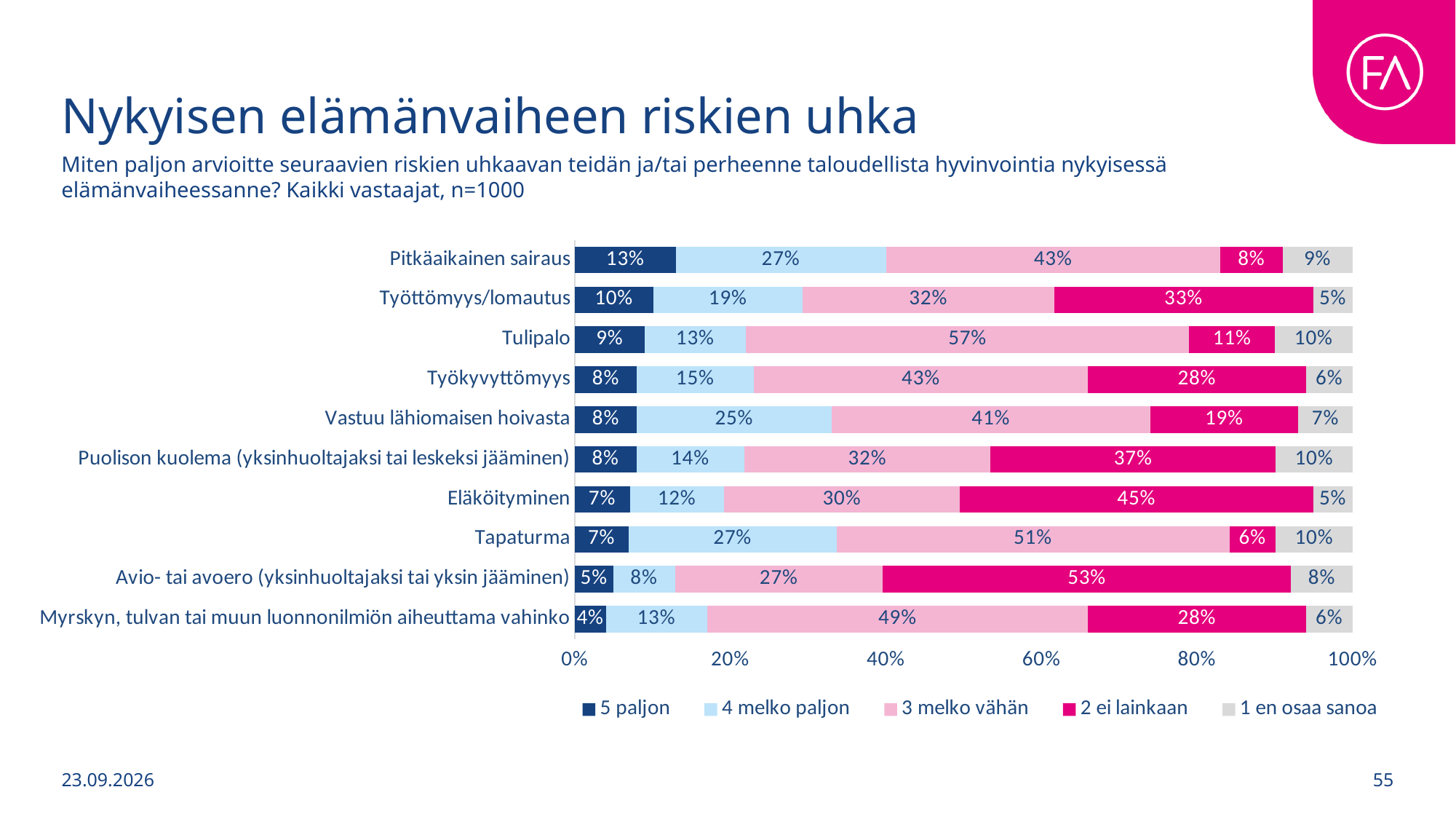
Which category has the highest "2 ei lainkaan" share? Avio- tai avoero (yksinhuoltajaksi tai yksin jääminen) Which category has the lowest "5 paljon" share? Myrskyn, tulvan tai muun luonnonilmiön aiheuttama vahinko Which has a larger "4 melko paljon" value: Pitkäaikainen sairaus or Vastuu lähiomaisen hoivasta? Pitkäaikainen sairaus What percentage of respondents answered "5 paljon" for Pitkäaikainen sairaus? 13% What is the "1 en osaa sanoa" value for Tulipalo? 10% What type of chart is shown on the slide? Stacked bar chart How many risk categories are shown in the chart? 10 How many percentage points higher is the "3 melko vähän" value for Tulipalo than for Tapaturma? 6 percentage points Which category has the highest "3 melko vähän" share? Tulipalo How many series does the legend list? 5 Which legend entry is shown in dark blue? 5 paljon What is the "2 ei lainkaan" value for Eläköityminen? 45%